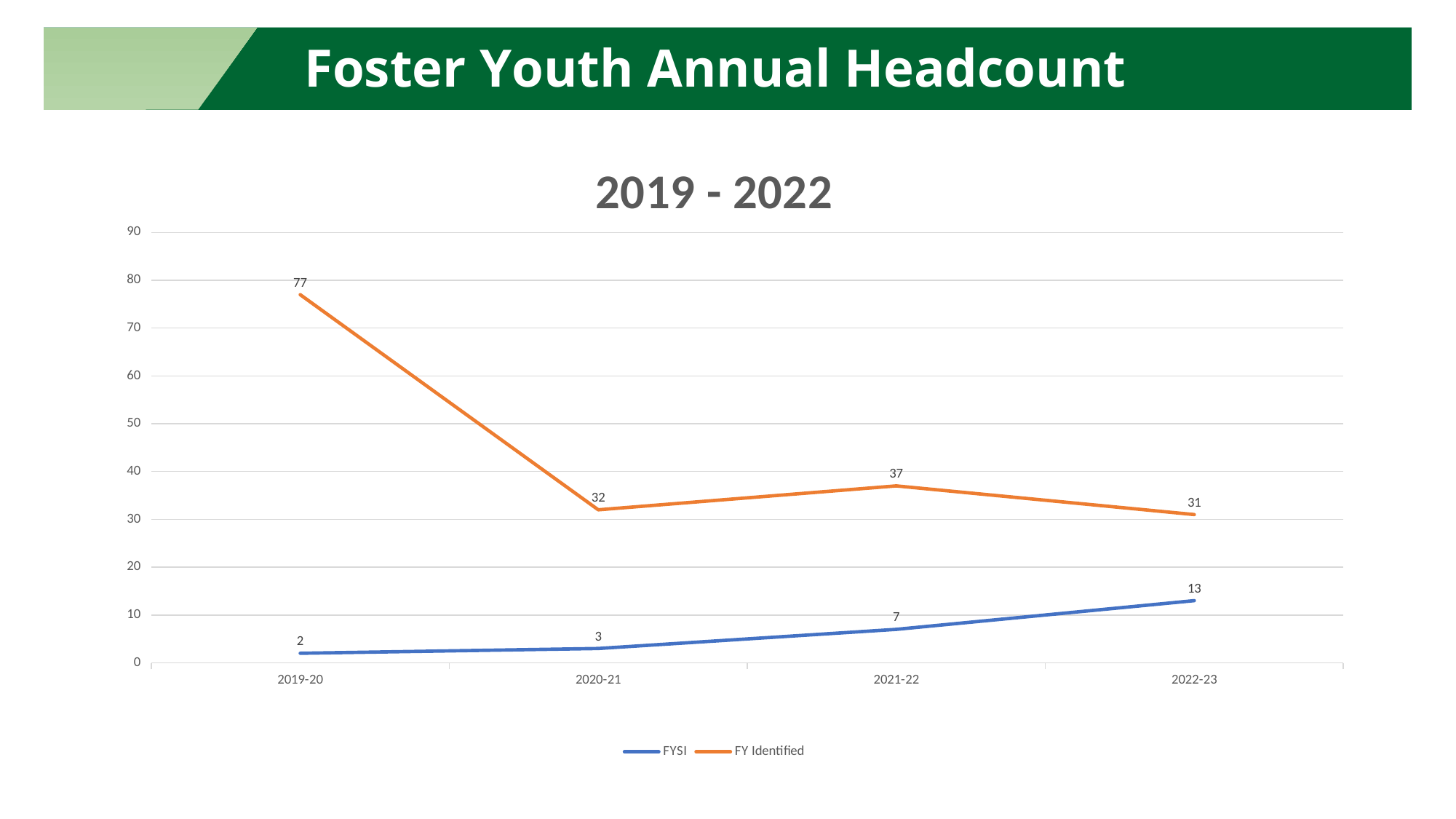
What is the difference between FY Identified and FYSI in 2022-23? 18 What kind of chart is shown? line chart What is the difference between the FY Identified values for 2019-20 and 2020-21? 45 Which is larger in 2021-22, FYSI or FY Identified? FY Identified What is the FY Identified value for 2019-20? 77 How many series does the legend list? 2 How many years are shown on the x axis? 4 Does the FYSI series rise or fall from 2019-20 to 2022-23? rise What is the FY Identified value for 2022-23? 31 What is the FYSI value for 2021-22? 7 In which year is the FY Identified series highest? 2019-20 In which year is the FYSI series lowest? 2019-20